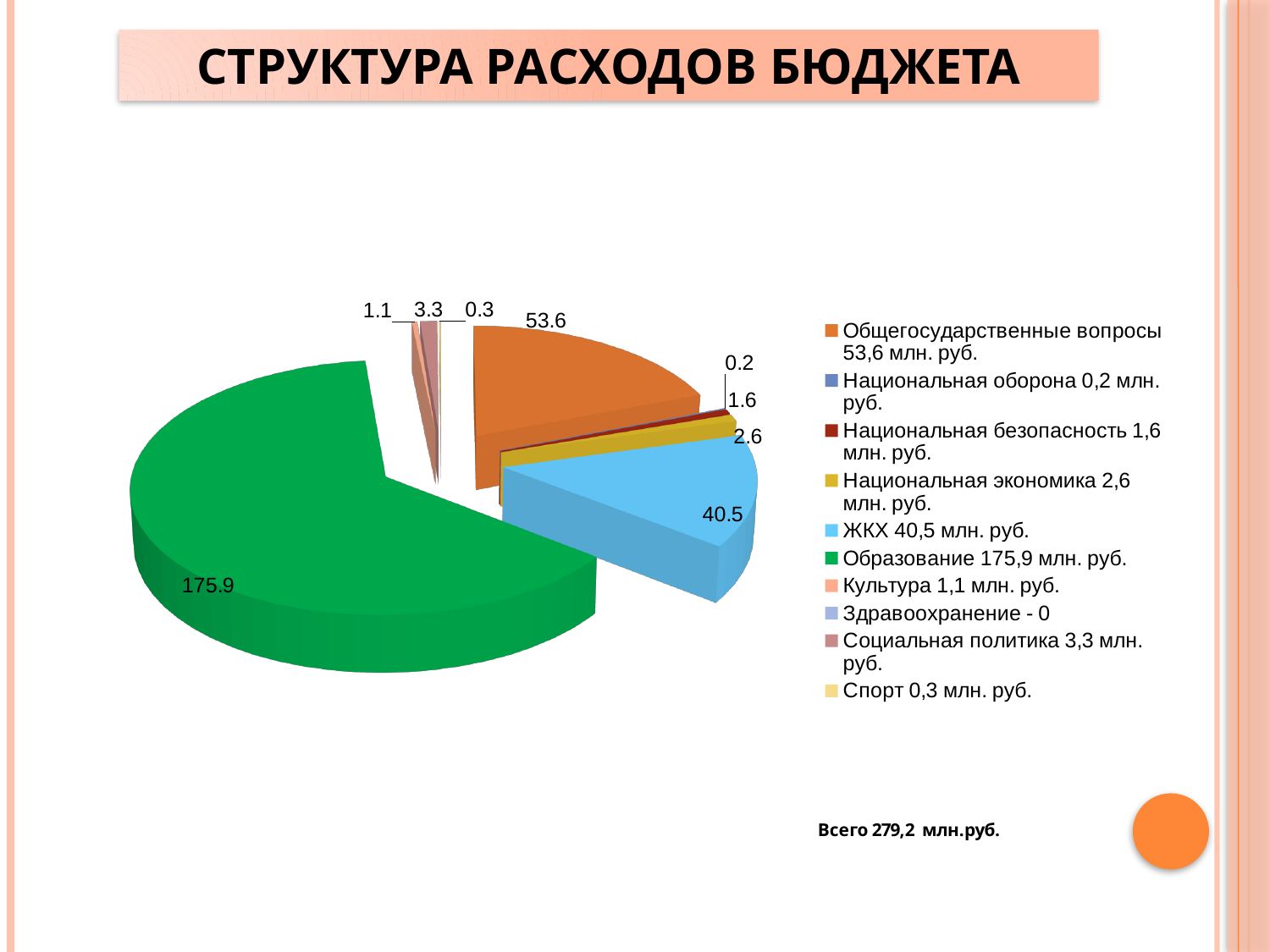
Which is larger, the value for ЖКХ or the value for Общегосударственные вопросы? Общегосударственные вопросы Which category has the smallest non-zero value in the legend? Национальная оборона Which category has the largest slice of the pie? Образование What type of chart is shown on the slide? pie chart What is the value shown for Социальная политика? 3.3 What is the value shown for Общегосударственные вопросы? 53.6 What is the title of the slide containing the chart? СТРУКТУРА РАСХОДОВ БЮДЖЕТА What total is stated below the chart? 279,2 млн.руб. What is the value shown for ЖКХ? 40.5 What is the value shown for Образование? 175.9 How many categories does the legend list? 10 What is the difference between the values for Образование and Общегосударственные вопросы? 122.3